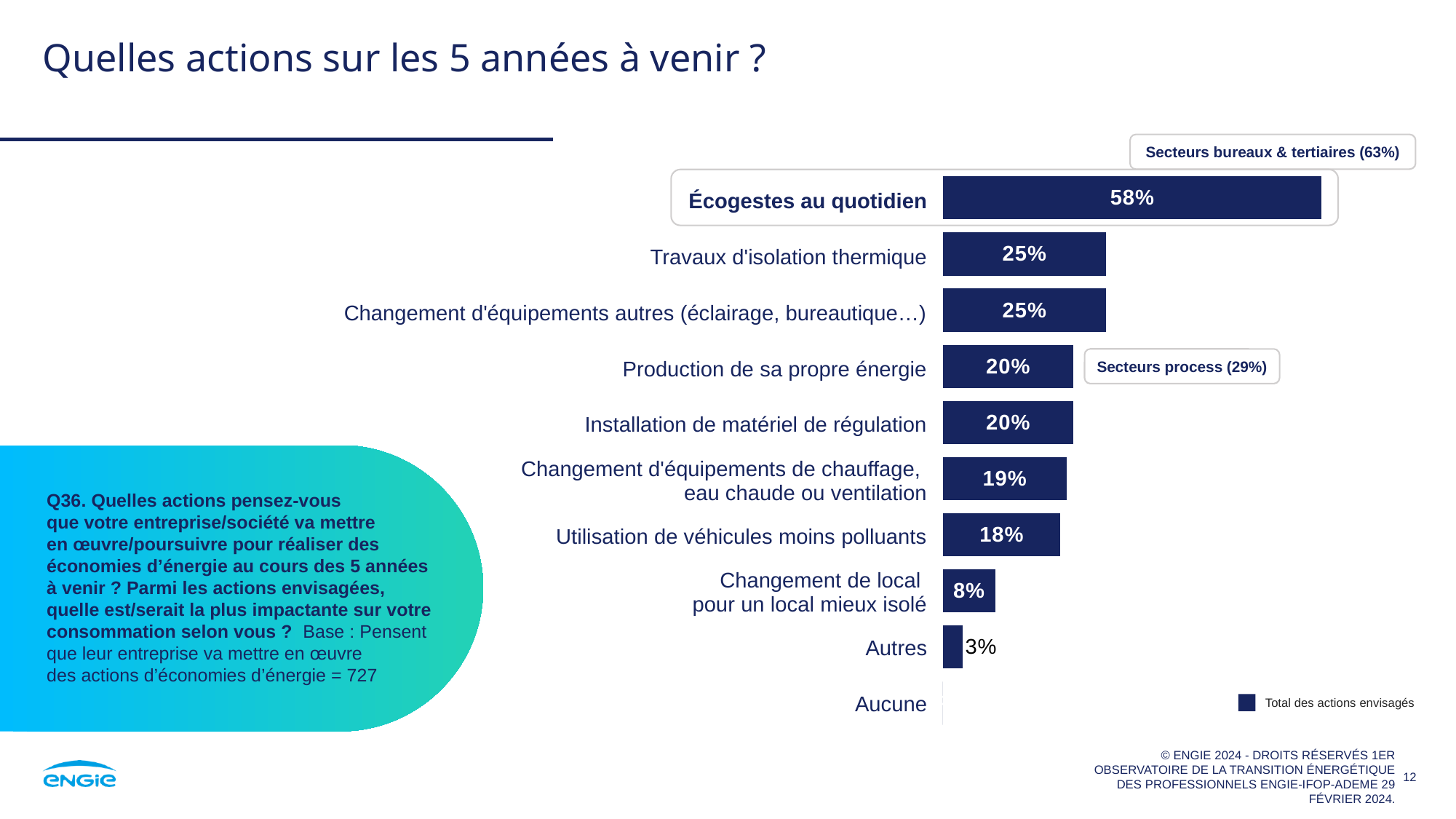
Which category has the highest value? Écogestes au quotidien What kind of chart is shown on the slide? Bar chart What is the value for "Écogestes au quotidien"? 58% How many categories are listed on the chart's axis? 10 What is the value for "Changement de local pour un local mieux isolé"? 8% What is the value for "Changement d'équipements de chauffage, eau chaude ou ventilation"? 19% Which is larger: the value for "Production de sa propre énergie" or the value for "Utilisation de véhicules moins polluants"? Production de sa propre énergie Among the categories with a printed value, which has the lowest value? Autres What is the legend entry shown on the chart? Total des actions envisagés What is the difference between the values for "Écogestes au quotidien" and "Travaux d'isolation thermique"? 33 percentage points What is the value for "Utilisation de véhicules moins polluants"? 18% How many series does the legend list? 1